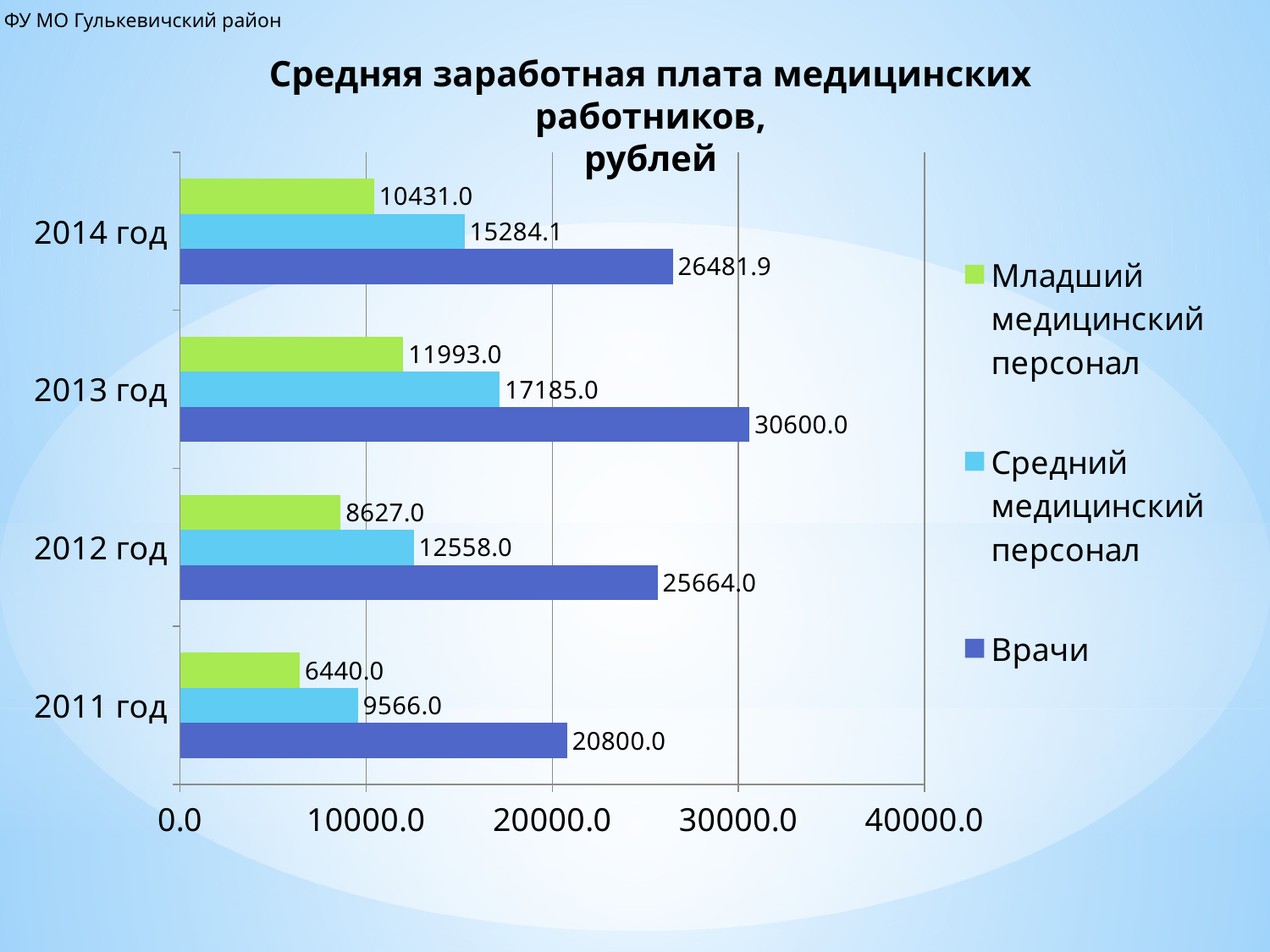
Is the value for Врачи in 2011 год greater or less than 20000.0? greater In which year is the salary of Врачи the highest? 2013 год Which is larger: the salary of Средний медицинский персонал in 2013 год or in 2014 год? 2013 год How many series does the legend list? 3 How many years are shown on the chart? 4 Which series is shown in green in the legend? Младший медицинский персонал What kind of chart is shown on the slide? bar chart What is the value for Средний медицинский персонал in 2014 год? 15284.1 In which year is the salary of Средний медицинский персонал the lowest? 2011 год What is the difference between the salary of Врачи and Младший медицинский персонал in 2012 год? 17037.0 What is the average salary of Врачи in 2013 год? 30600.0 What is the value for Младший медицинский персонал in 2011 год? 6440.0